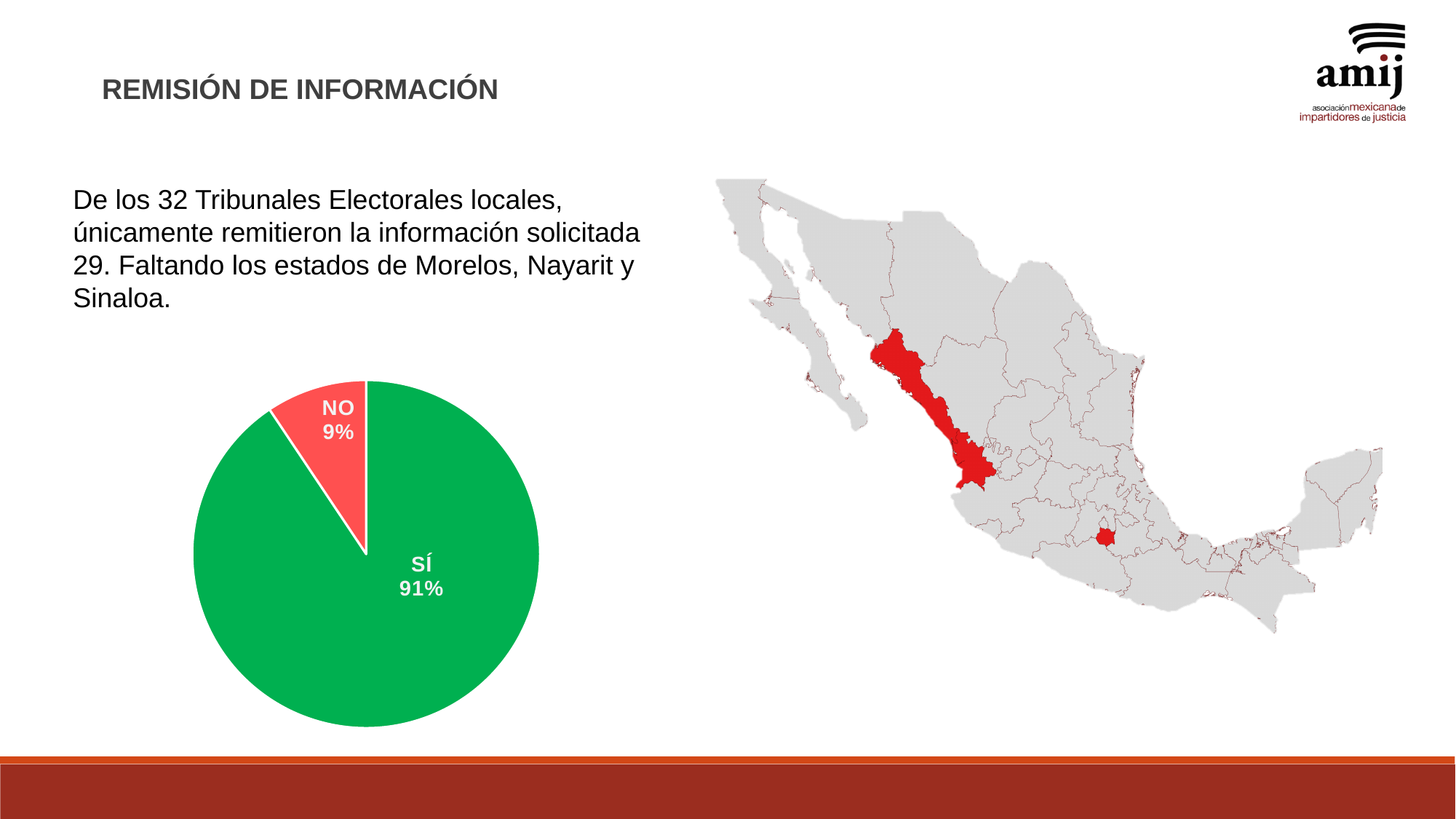
How many slices does the pie chart have? 2 What share of the pie does the SÍ slice represent? 91% What share of the pie does the NO slice represent? 9% Which slice of the pie chart is the largest? SÍ Which is larger, the SÍ slice or the NO slice? SÍ What colour is the NO slice of the pie chart? red Which slice of the pie chart is the smallest? NO What colour is the SÍ slice of the pie chart? green What kind of chart is shown on the slide? pie chart What is the difference in percentage points between the SÍ and NO slices? 82